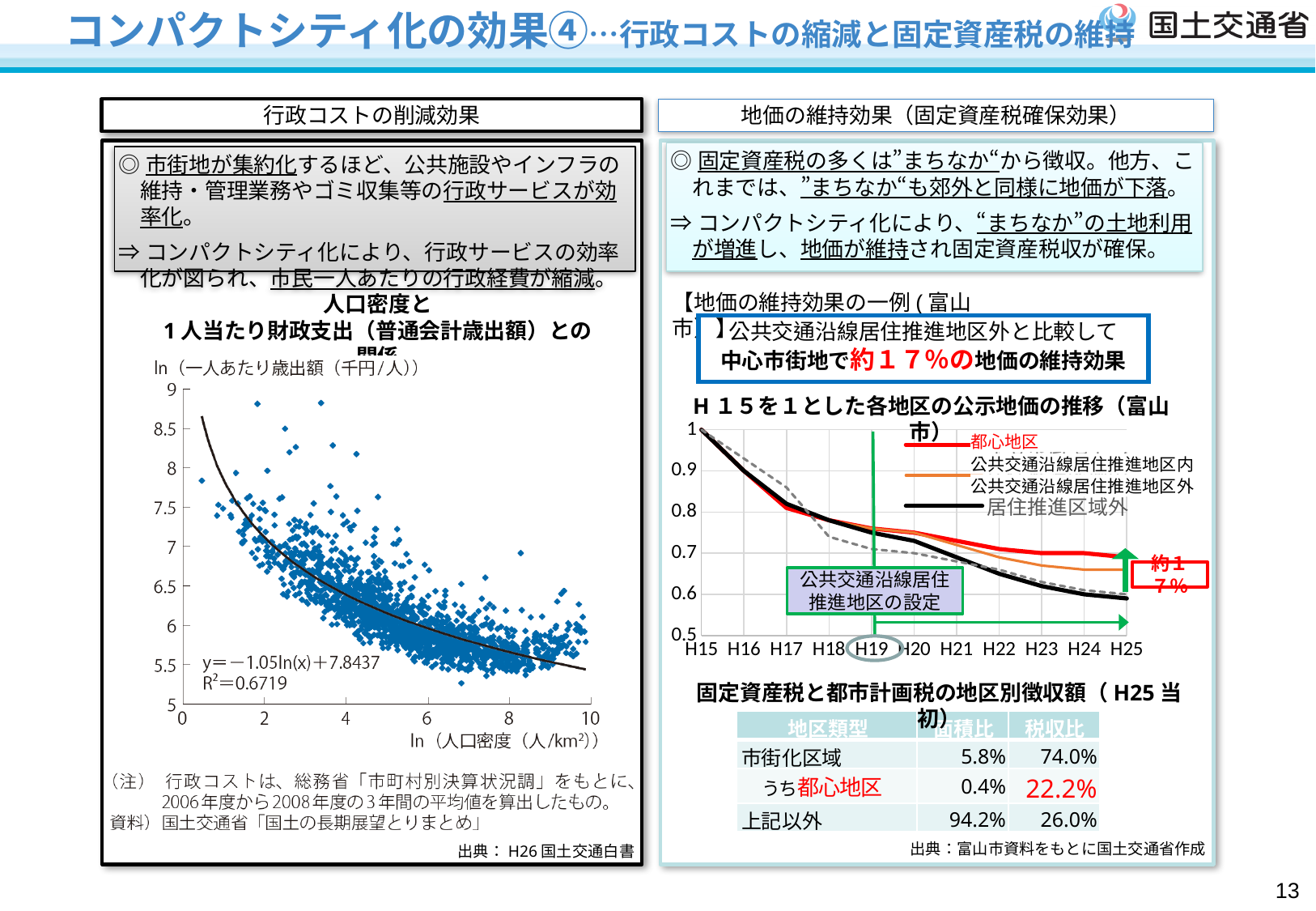
In the right line chart H15を1とした各地区の公示地価の推移（富山市）, what is the value of every series at H15? 1 In the right line chart H15を1とした各地区の公示地価の推移（富山市）, is the value for 居住推進区域外 at H25 greater or less than 0.7? less What kind of chart is the right chart titled H15を1とした各地区の公示地価の推移（富山市）? line chart What kind of chart is the left chart titled 人口密度と1人当たり財政支出（普通会計歳出額）との関係? scatter plot In the right line chart H15を1とした各地区の公示地価の推移（富山市）, which series has the highest value at H25? 都心地区 In the left scatter chart, what is the regression equation printed on the chart? y=−1.05ln(x)+7.8437 In the left scatter chart, what is the R² value printed on the chart? R²=0.6719 In the right line chart H15を1とした各地区の公示地価の推移（富山市）, how many years are shown on the x axis? 11 In the right line chart H15を1とした各地区の公示地価の推移（富山市）, do the values rise or fall from H15 to H25? fall In the right line chart H15を1とした各地区の公示地価の推移（富山市）, is the value for 都心地区 at H25 greater or less than 0.6? greater In the right line chart H15を1とした各地区の公示地価の推移（富山市）, how many series does the legend list? 4 In the left scatter chart, do the values of ln(一人あたり歳出額) rise or fall as ln(人口密度) increases along the x axis? fall